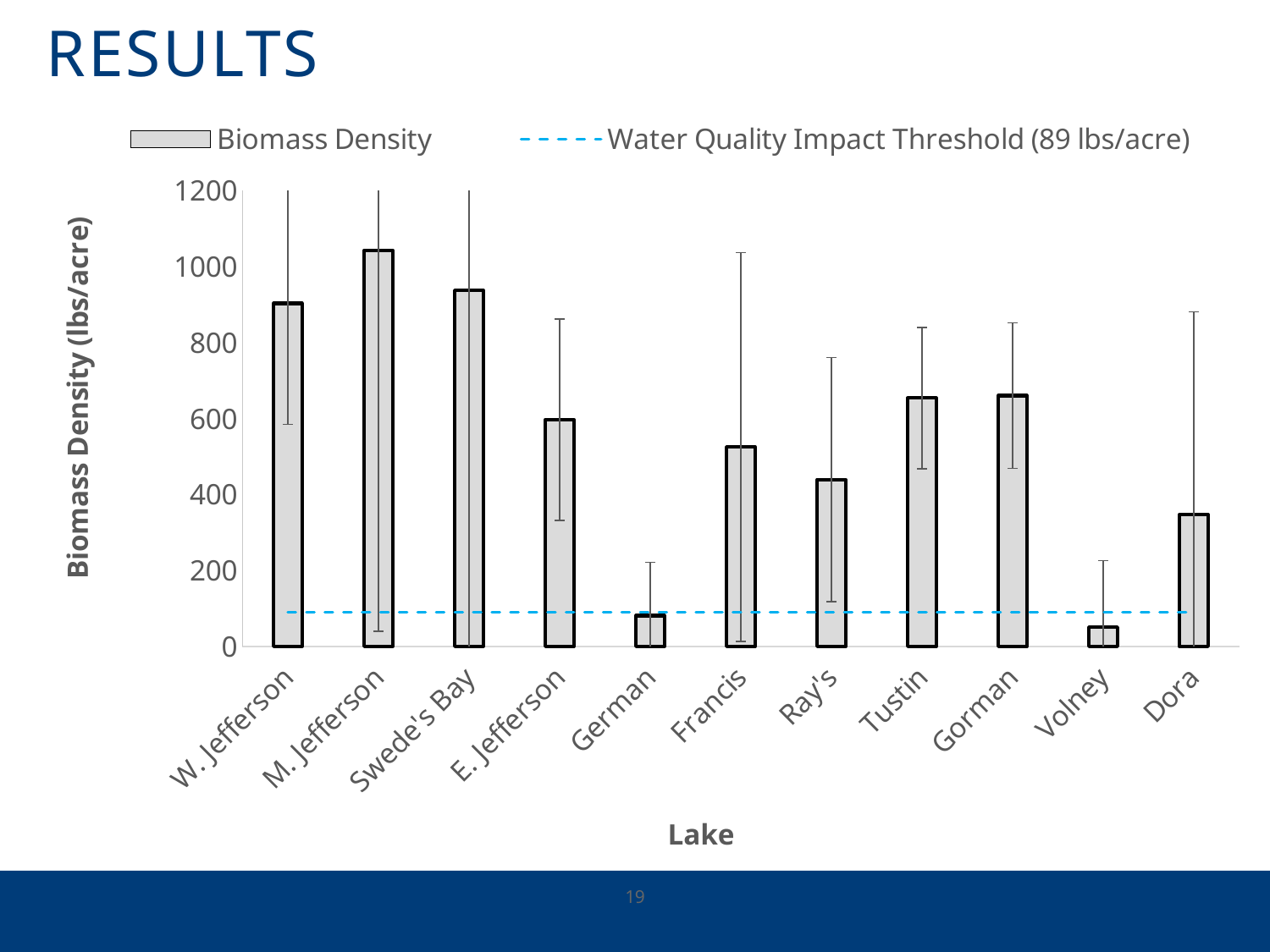
Is the biomass density for Francis greater or less than 400? greater What kind of chart is shown on the slide? bar chart Is the biomass density for W. Jefferson greater or less than 800? greater Which lake has the lowest biomass density? Volney Is the biomass density for German greater or less than 200? less Which lake has the highest biomass density? M. Jefferson How many lakes are shown on the x axis of the chart? 11 How many entries does the chart's legend list? 2 Which lake has a higher biomass density, Ray's or Tustin? Tustin What value does the dashed line in the chart represent, according to the legend? Water Quality Impact Threshold (89 lbs/acre) Which lake has a higher biomass density, W. Jefferson or E. Jefferson? W. Jefferson